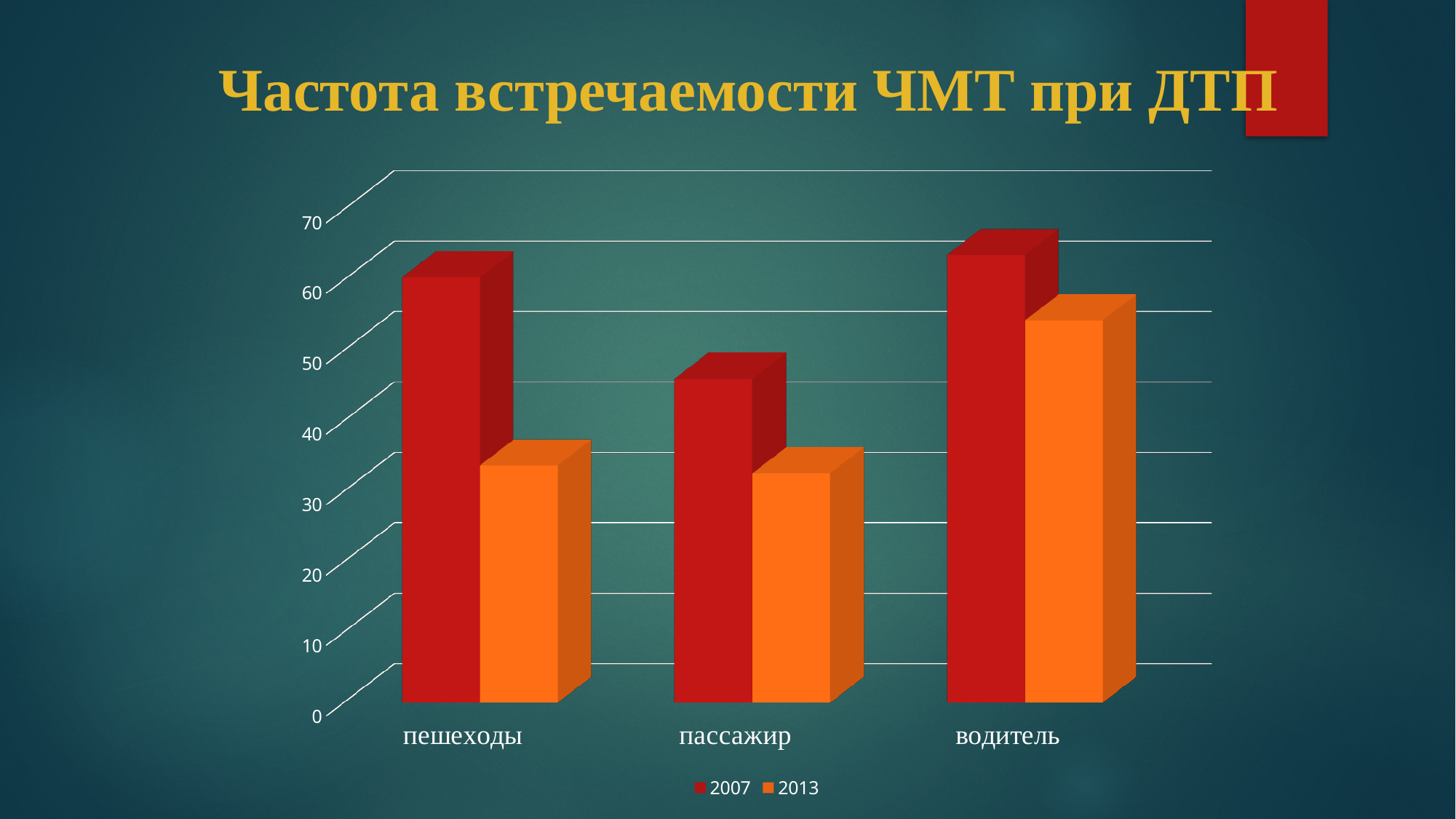
What is the title of the chart on the slide? Частота встречаемости ЧМТ при ДТП Is the value for водитель in the 2013 series greater or less than 50? greater Is the value for пассажир in the 2013 series greater or less than 40? less Which category has the highest value for the 2013 series? водитель For пешеходы, which series has the larger value, 2007 or 2013? 2007 For водитель, which series has the larger value, 2007 or 2013? 2007 Which category has the lowest value for the 2007 series? пассажир What kind of chart is shown on the slide? bar chart Is the value for пешеходы in the 2007 series greater or less than 50? greater Which series does the orange colour represent in the chart? 2013 How many categories are shown on the x axis of the chart? 3 How many series does the chart legend list? 2